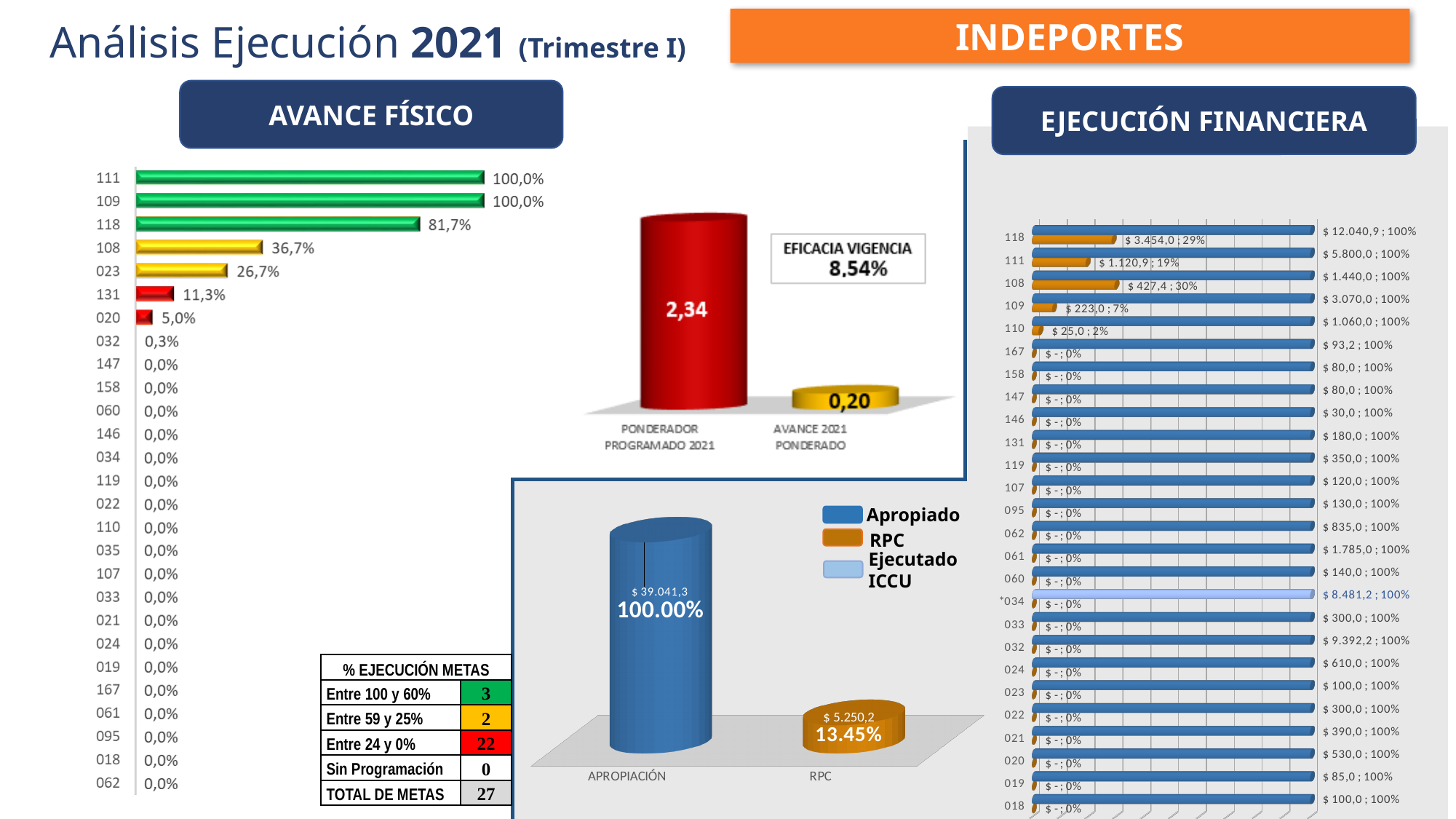
In the APROPIACIÓN / RPC chart, what percentage is shown for RPC? 13.45% In the AVANCE FÍSICO chart, what is the value for category 118? 81,7% In the EJECUCIÓN FINANCIERA chart, which category has the highest Apropiado value? 118 In the AVANCE FÍSICO chart, what is the value for category 023? 26,7% In the chart with PONDERADOR PROGRAMADO 2021 and AVANCE 2021 PONDERADO, what is the value for AVANCE 2021 PONDERADO? 0,20 How many categories are plotted in the AVANCE FÍSICO chart? 27 How many series does the legend of the EJECUCIÓN FINANCIERA chart list? 3 In the chart with PONDERADOR PROGRAMADO 2021 and AVANCE 2021 PONDERADO, what is the difference between the two values? 2,14 In the AVANCE FÍSICO chart, what is the difference between the values for 108 and 131? 25,4% What kind of chart is the AVANCE FÍSICO chart? bar chart In the AVANCE FÍSICO chart, which is larger, the value for 020 or the value for 032? 020 In the EJECUCIÓN FINANCIERA chart, what is the RPC value for category 108? $ 427,4 ; 30%